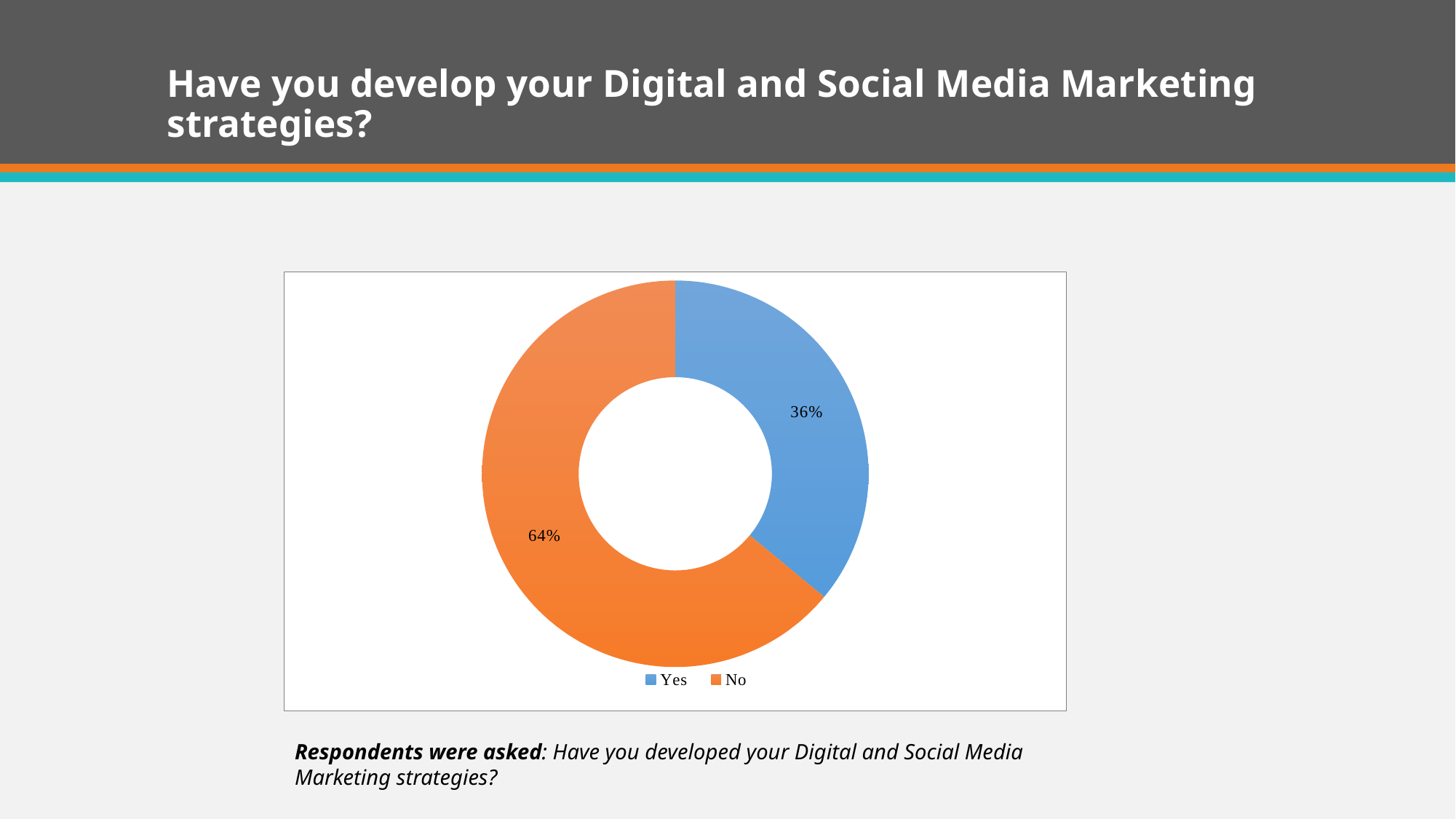
How many categories are shown in the chart? 2 Which response has the smallest share of the chart? Yes What is the difference in percentage points between the "No" and "Yes" shares? 28 What share of the chart does the "No" slice represent? 64% Which is larger, the share for "Yes" or the share for "No"? No What percentage of respondents answered "Yes"? 36% What colour is used for the "Yes" slice? Blue What percentage of respondents answered "No"? 64% Which response has the largest share of the chart? No What kind of chart is shown on the slide? Doughnut chart What are the two entries listed in the chart legend? Yes and No